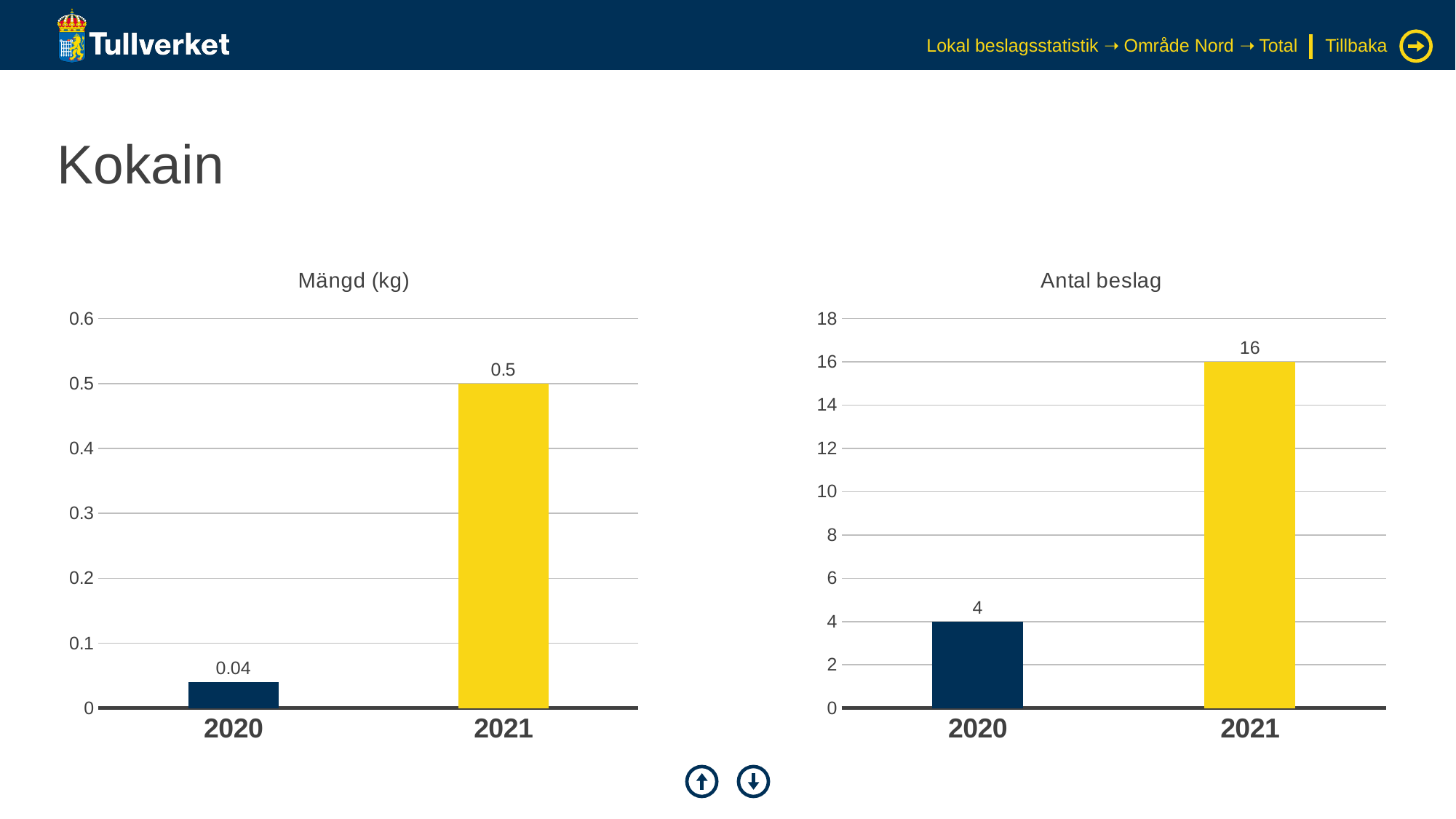
In the 'Antal beslag' chart, which year has the highest value? 2021 In the 'Antal beslag' chart, what is the value for 2020? 4 In the 'Antal beslag' chart, what is the difference between the values for 2021 and 2020? 12 In the 'Antal beslag' chart, do the values rise or fall from 2020 to 2021? rise In the 'Mängd (kg)' chart, what is the difference between the values for 2021 and 2020? 0.46 In the 'Mängd (kg)' chart, what is the value for 2020? 0.04 In the 'Mängd (kg)' chart, what is the value for 2021? 0.5 In the 'Mängd (kg)' chart, which is larger, the value for 2020 or 2021? 2021 In the 'Antal beslag' chart, what is the value for 2021? 16 What kind of chart is the 'Mängd (kg)' chart? bar chart How many categories are shown in the 'Antal beslag' chart? 2 In the 'Mängd (kg)' chart, which year has the lowest value? 2020